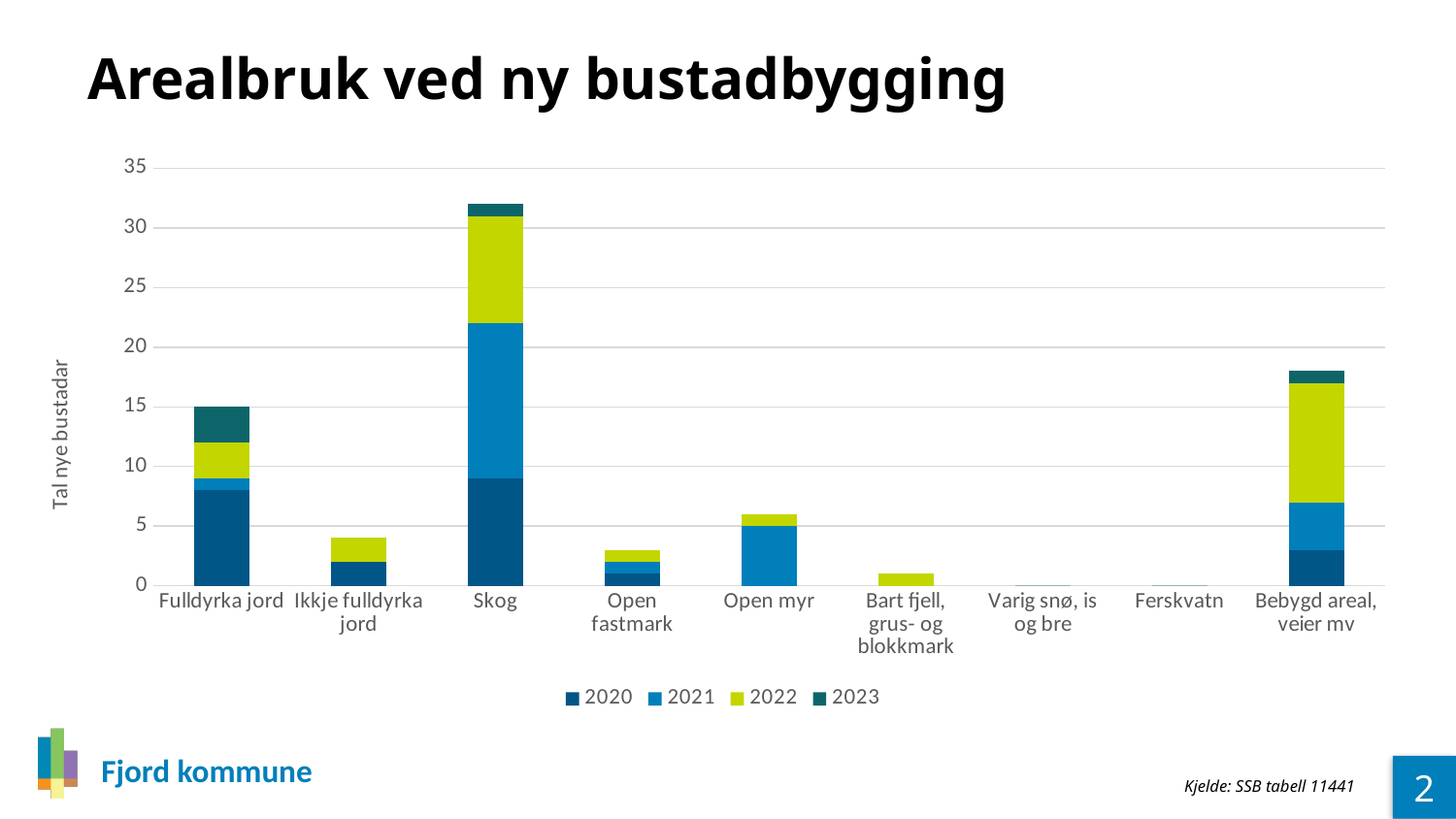
What is the title of the chart? Arealbruk ved ny bustadbygging Which category has the highest total number of new dwellings? Skog Is the total value for Ikkje fulldyrka jord greater or less than 5? less What is the label on the y axis? Tal nye bustadar Is the total value for Bebygd areal, veier mv greater or less than 15? greater Is the total value for Open fastmark greater or less than 5? less Which has a larger total, Skog or Bebygd areal, veier mv? Skog How many land-use categories are shown on the x axis? 9 What kind of chart is shown on the slide? Stacked bar chart Which has a larger total, Fulldyrka jord or Ikkje fulldyrka jord? Fulldyrka jord How many series does the legend list? 4